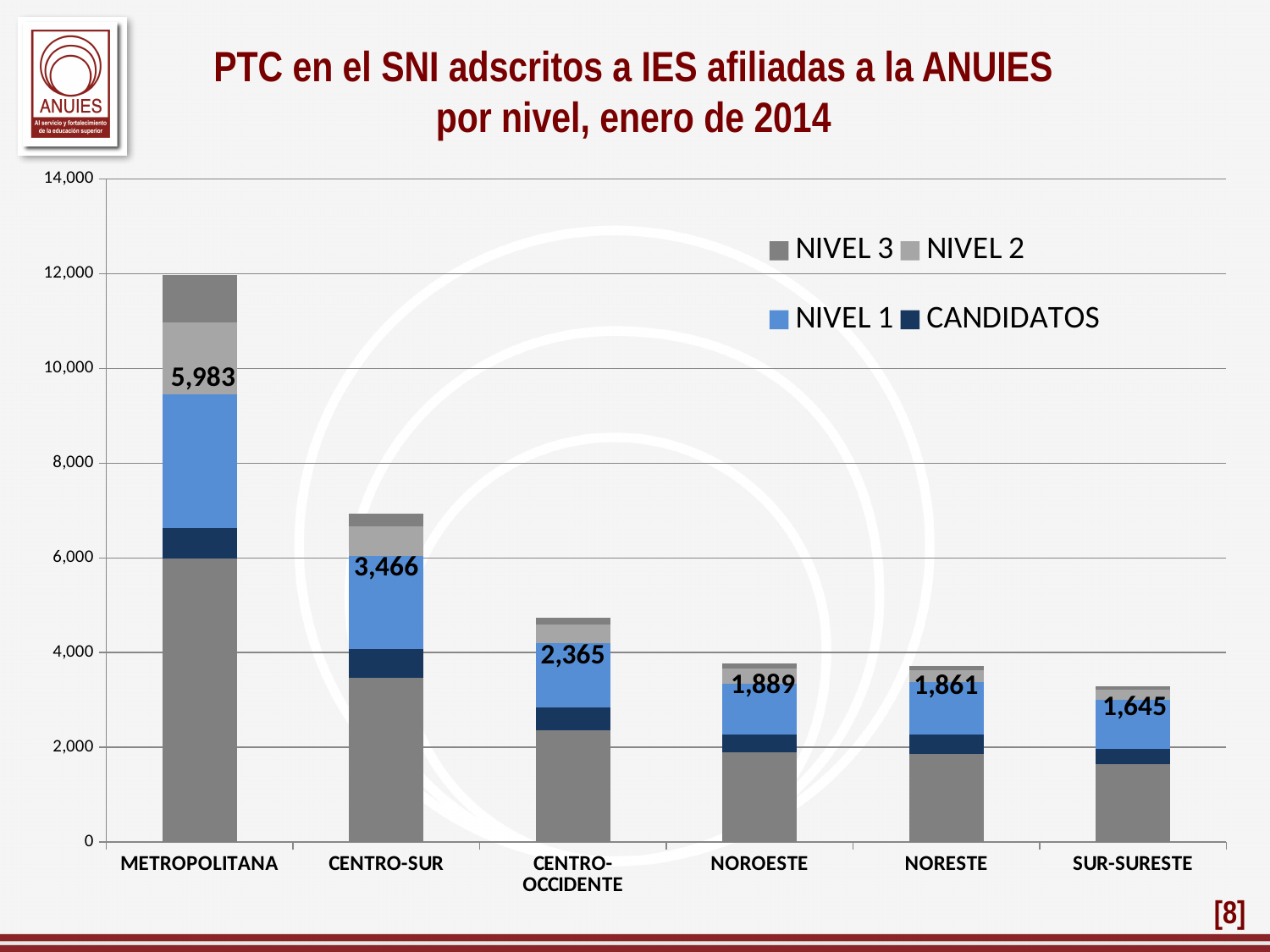
What value is labelled on the CENTRO-SUR bar? 3,466 Which has the larger labelled value, NOROESTE or NORESTE? NOROESTE Is the total height of the METROPOLITANA bar greater or less than 10,000? greater How many series does the legend list? 4 What is the difference between the labelled values for METROPOLITANA and CENTRO-SUR? 2,517 What value is labelled on the METROPOLITANA bar? 5,983 What kind of chart is shown on the slide? Stacked bar chart Which region has the tallest stacked bar? METROPOLITANA What is the title of the chart? PTC en el SNI adscritos a IES afiliadas a la ANUIES por nivel, enero de 2014 How many regions (categories) are shown on the x axis? 6 What value is labelled on the SUR-SURESTE bar? 1,645 Which region has the shortest stacked bar? SUR-SURESTE